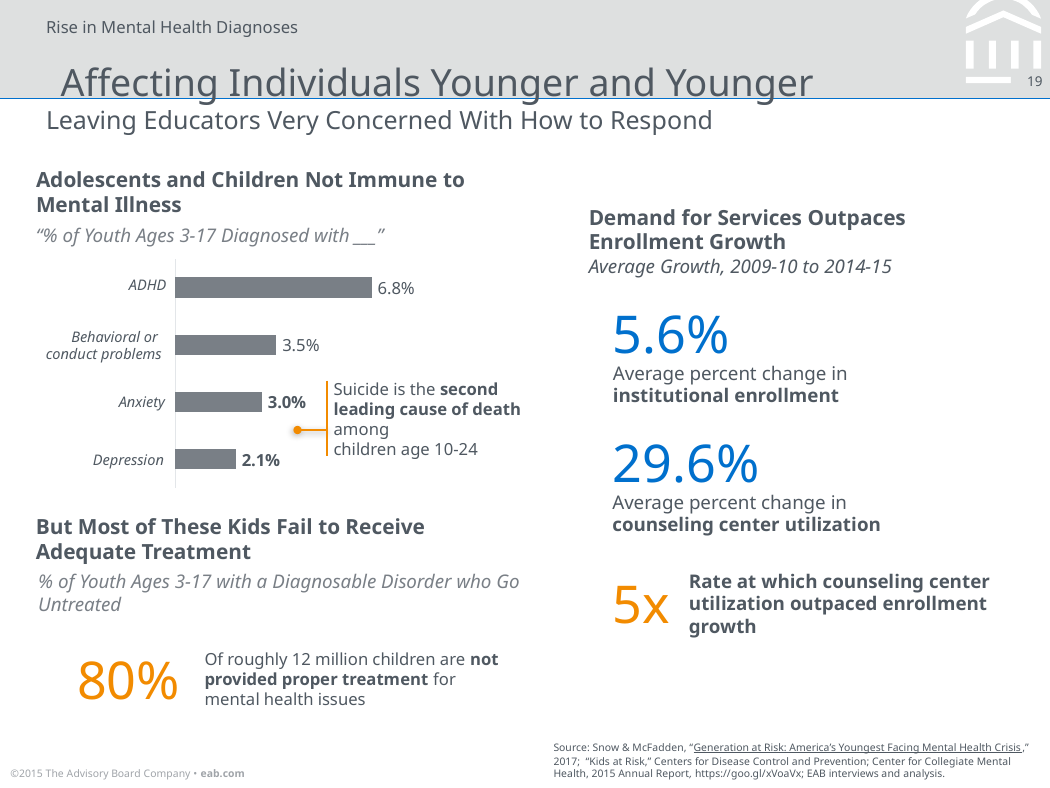
Which category has the highest value in the bar chart? ADHD What is the value shown for Behavioral or conduct problems in the bar chart? 3.5% What is the difference between the ADHD value and the Depression value in the bar chart? 4.7% What percentage of youth ages 3-17 are diagnosed with ADHD according to the bar chart? 6.8% What is the value shown for Depression in the bar chart? 2.1% What is the difference between the Behavioral or conduct problems value and the Anxiety value in the bar chart? 0.5% Which category has the lowest value in the bar chart? Depression Which is larger in the bar chart, the value for ADHD or the value for Behavioral or conduct problems? ADHD What is the value shown for Anxiety in the bar chart? 3.0% What is the subtitle of the bar chart, shown in italics above it? "% of Youth Ages 3-17 Diagnosed with ___" What type of chart is used to show the percentage of youth diagnosed with each condition? Bar chart How many categories are shown in the bar chart? 4